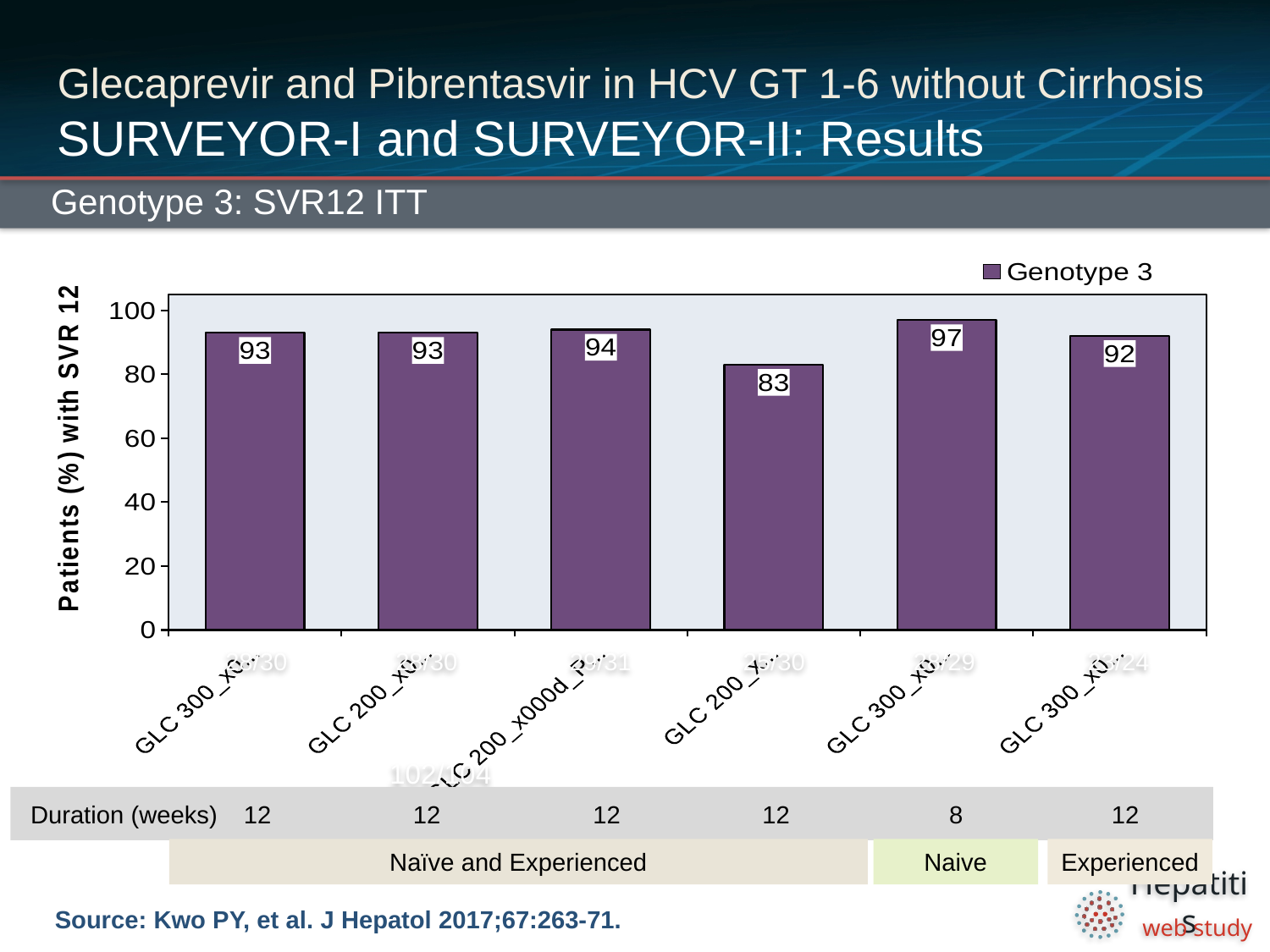
What is the SVR12 value for the 12-week Experienced group (sixth bar)? 92 How many bars are plotted in the chart? 6 What is the difference between the highest bar (97) and the lowest bar (83)? 14 What is the legend entry for the series in the chart? Genotype 3 Which bar has the highest value in the chart? the fifth bar (8-week Naive group), 97 Which bar has the lowest value in the chart? the fourth bar from the left, 83 How many series does the legend list? 1 What is the label on the vertical axis of the chart? Patients (%) with SVR 12 What is the value shown on the fourth bar from the left? 83 What is the SVR12 value for the 8-week Naive group (fifth bar)? 97 What kind of chart is shown on the slide? bar chart What is the value shown on the third bar from the left? 94